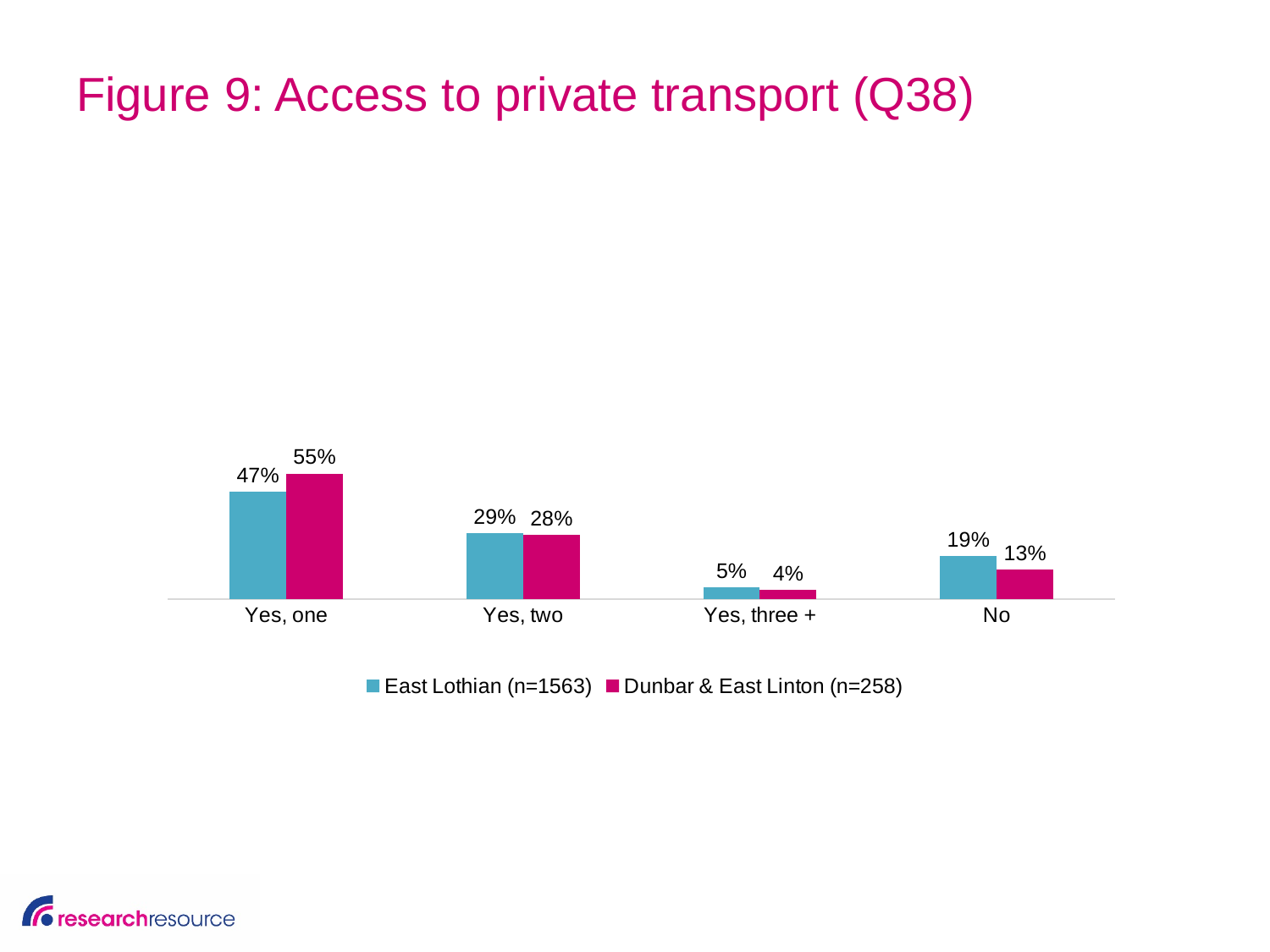
What is the difference between the East Lothian and Dunbar & East Linton values in the 'No' category? 6% Which category has the highest value for Dunbar & East Linton? Yes, one How many series does the legend list? 2 What is the title of the chart? Figure 9: Access to private transport (Q38) What is the value for Dunbar & East Linton in the 'No' category? 13% What kind of chart is shown on the slide? Bar chart Which category has the lowest value for East Lothian? Yes, three + What is the difference between the Dunbar & East Linton and East Lothian values in the 'Yes, one' category? 8% What is the value for Dunbar & East Linton in the 'Yes, two' category? 28% What is the value for East Lothian in the 'Yes, one' category? 47% How many categories are shown on the x axis? 4 Which is larger in the 'No' category: East Lothian or Dunbar & East Linton? East Lothian